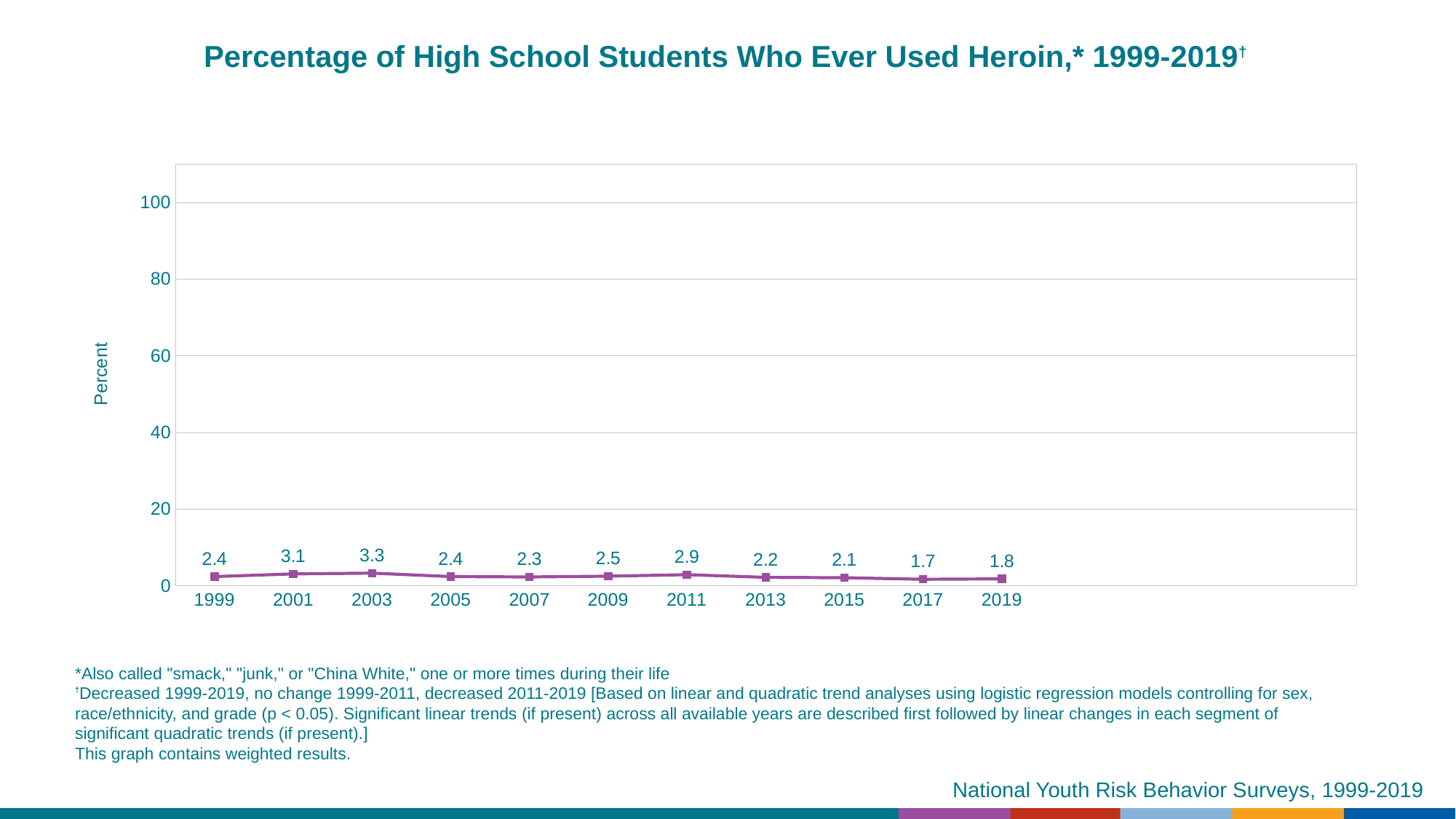
What is the value plotted for 2019? 1.8 Which year has the highest percentage of students who ever used heroin? 2003 What is the difference between the 1999 value and the 2017 value? 0.7 Is the value for 2011 greater or less than 20? less What is the label on the vertical axis? Percent What is the difference between the 2003 value and the 2019 value? 1.5 How many years are plotted on the chart? 11 What kind of chart is shown on the slide? line chart What is the value plotted for 2011? 2.9 What percentage of high school students had ever used heroin in 2003? 3.3 Which year has the lowest percentage of students who ever used heroin? 2017 Which year has a higher value, 2001 or 2013? 2001